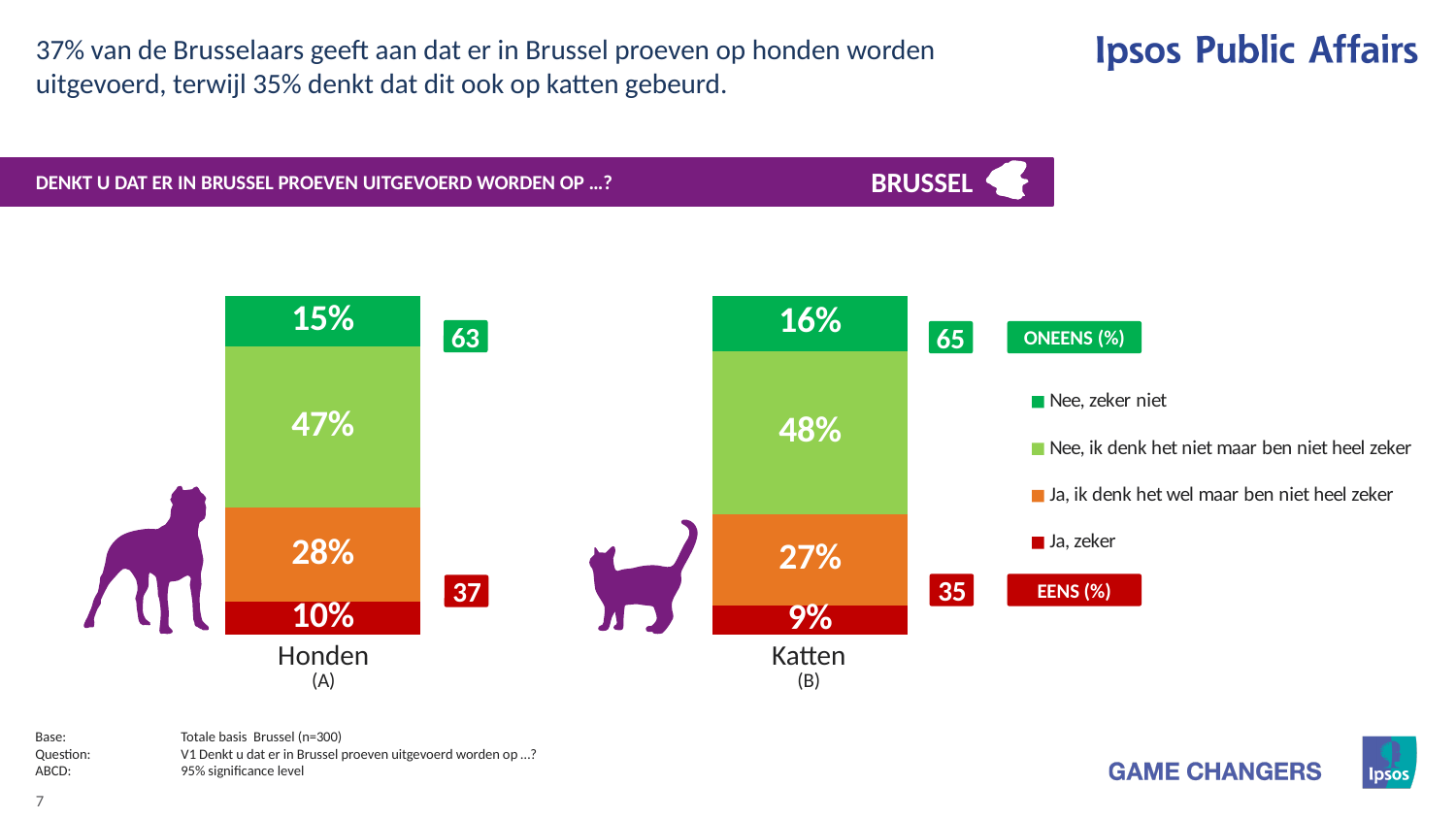
What percentage of respondents answered "Ja, ik denk het wel maar ben niet heel zeker" for Honden? 28% What is the EENS (%) value shown for Katten? 35 Which category has the larger "Ja, zeker" share, Honden or Katten? Honden What is the difference between the ONEENS (%) values for Katten and Honden? 2 What percentage of respondents answered "Nee, zeker niet" for Katten? 16% What is the ONEENS (%) value shown for Honden? 63 What kind of chart is shown on the slide? Stacked bar chart What is the difference between the "Nee, ik denk het niet maar ben niet heel zeker" values for Katten and Honden? 1% How many series does the legend list? 4 How many categories are shown on the x axis of the chart? 2 What percentage of respondents answered "Ja, zeker" for Honden? 10% What percentage of respondents answered "Nee, ik denk het niet maar ben niet heel zeker" for Katten? 48%